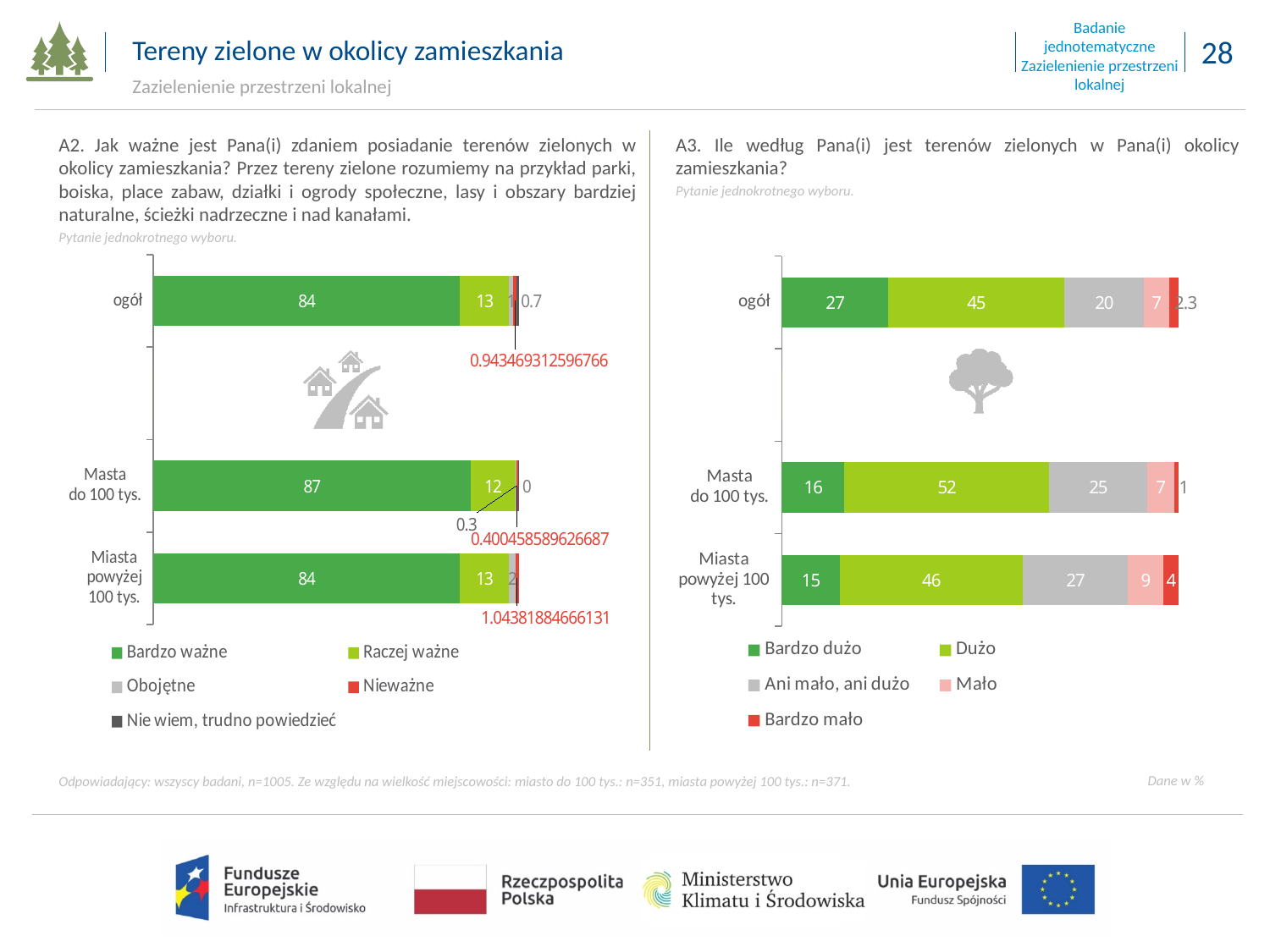
What type of chart is the A2 chart on the left? Stacked bar chart In the A2 chart on the left, how many categories are shown on the vertical axis? 3 In the A3 chart on the right, which category has the highest value for 'Bardzo dużo'? ogół In the A3 chart on the right, what is the difference between the 'Dużo' values for 'Miasta do 100 tys.' and 'Miasta powyżej 100 tys.'? 6 In the A3 chart on the right, which category has the lowest value for 'Dużo'? ogół In the A3 chart on the right, what is the value of 'Dużo' for 'ogół'? 45 In the A3 chart on the right, what is the value of 'Bardzo mało' for 'Miasta powyżej 100 tys.'? 4 In the A3 chart on the right, how many series does the legend list? 5 In the A3 chart on the right, what is the value of 'Ani mało, ani dużo' for 'Miasta powyżej 100 tys.'? 27 In the A2 chart on the left, what is the value of 'Bardzo ważne' for 'Miasta do 100 tys.'? 87 In the A3 chart on the right, is the 'Bardzo dużo' value larger for 'ogół' or for 'Miasta do 100 tys.'? ogół In the A2 chart on the left, what is the value of 'Raczej ważne' for 'ogół'? 13